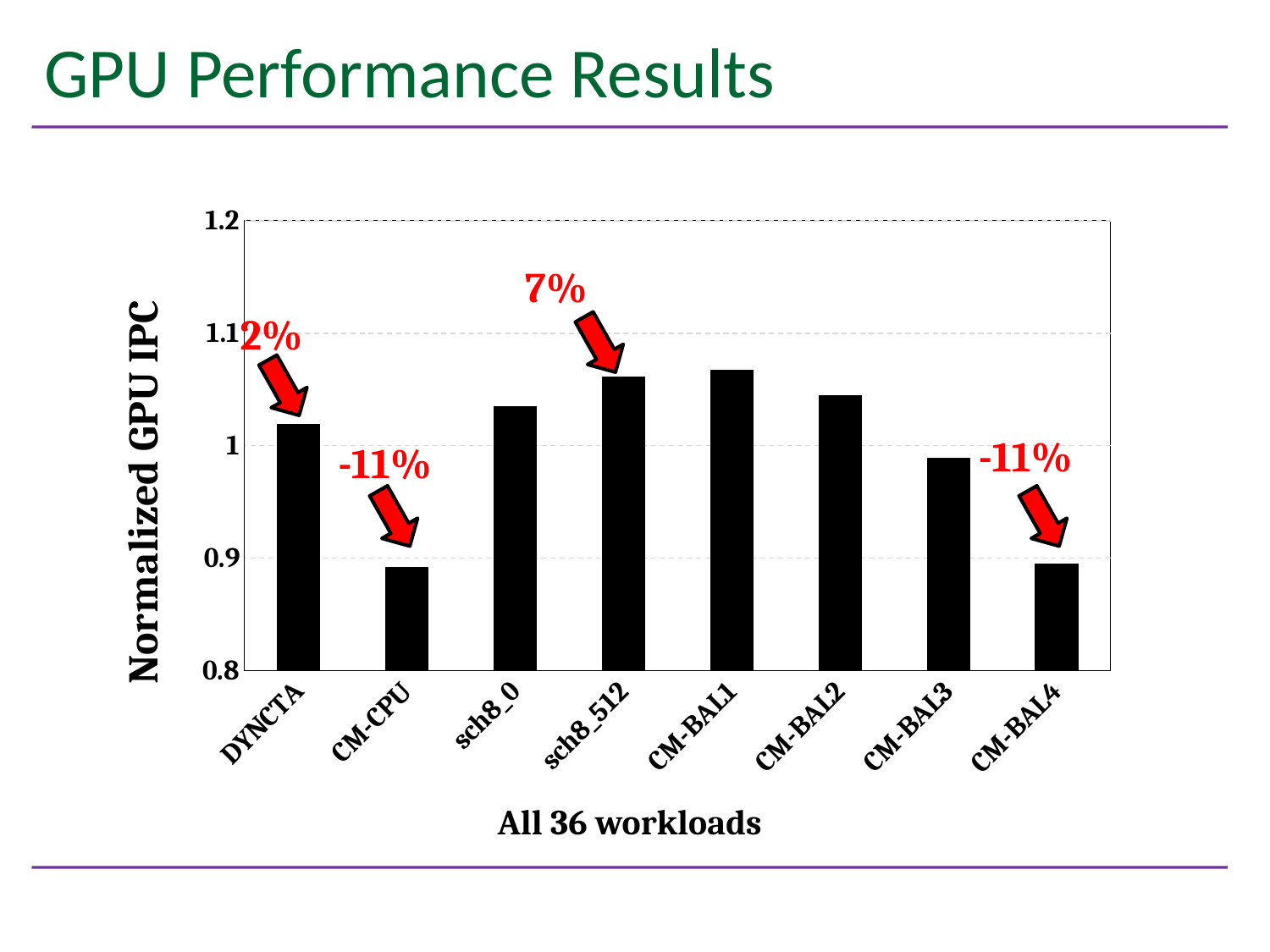
Is the value for CM-BAL1 greater or less than 1? greater What percentage annotation is shown above the sch8_512 bar? 7% What kind of chart is shown on the slide? bar chart What is the y-axis label of the chart? Normalized GPU IPC How many categories are plotted on the x axis of the chart? 8 What percentage annotation is shown above the DYNCTA bar? 2% Is the value for CM-CPU greater or less than 0.9? less What is the x-axis label of the chart? All 36 workloads Which has the larger value, sch8_512 or CM-CPU? sch8_512 Is the value for DYNCTA greater or less than 1? greater What percentage annotation is shown above the CM-CPU bar? -11% What percentage annotation is shown above the CM-BAL4 bar? -11%